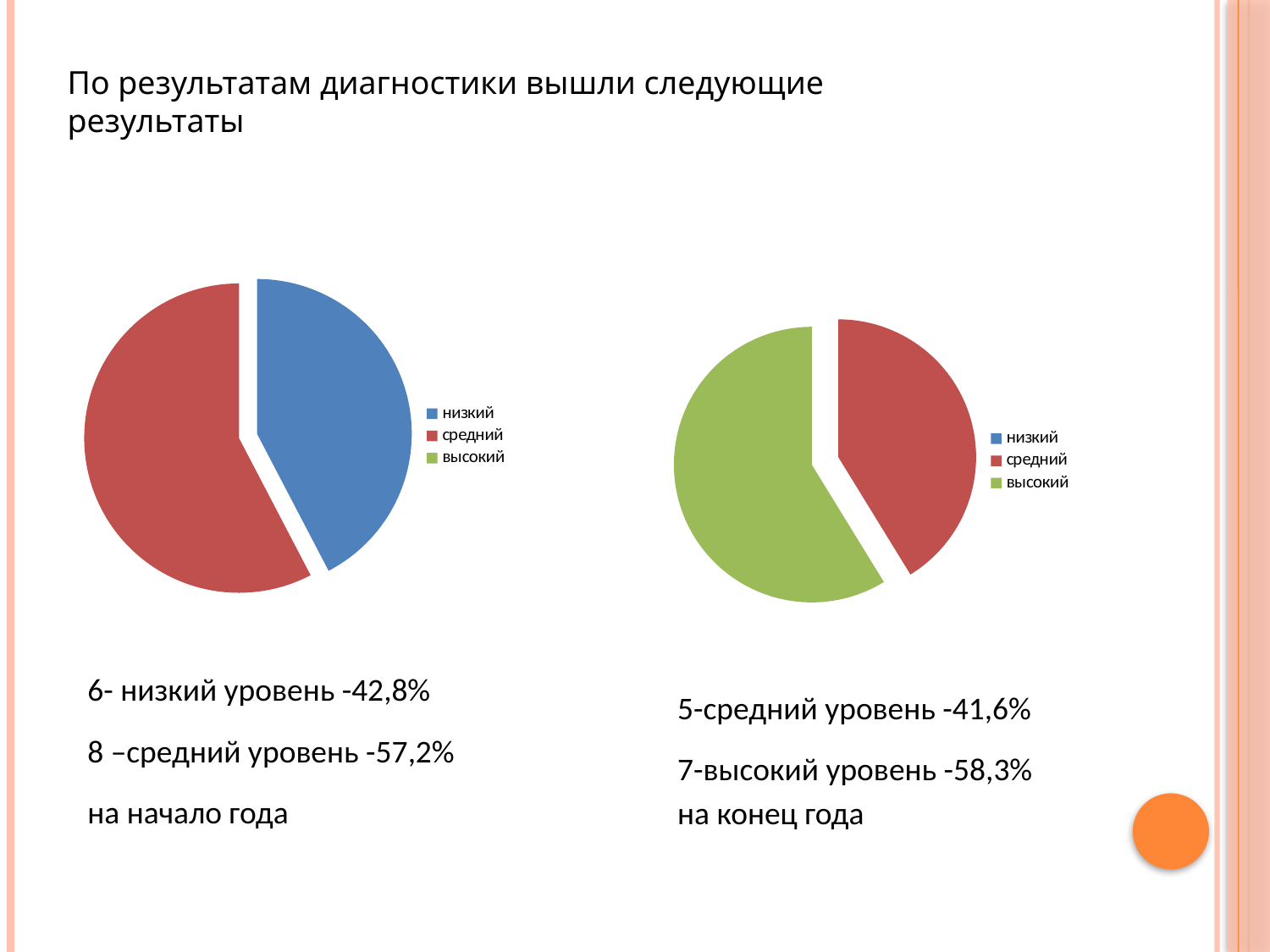
In the right chart (на конец года), what colour represents высокий? green How many slices are visible in the left pie chart (на начало года)? 2 How many entries does the legend of the right chart (на конец года) list? 3 In the right chart (на конец года), what share does высокий уровень have according to the text below it? 58,3% In the left chart (на начало года), what share does средний уровень have according to the text below it? 57,2% In the left chart (на начало года), what is the difference between the средний share (57,2%) and the низкий share (42,8%)? 14,4% In the right chart (на конец года), what share does средний уровень have according to the text below it? 41,6% In the left chart (на начало года), which is larger: низкий or средний? средний In the left chart (на начало года), which category has the largest slice? средний What kind of chart is the left chart (на начало года)? pie chart In the left chart (на начало года), what share does низкий уровень have according to the text below it? 42,8% In the right chart (на конец года), which category has the largest slice? высокий